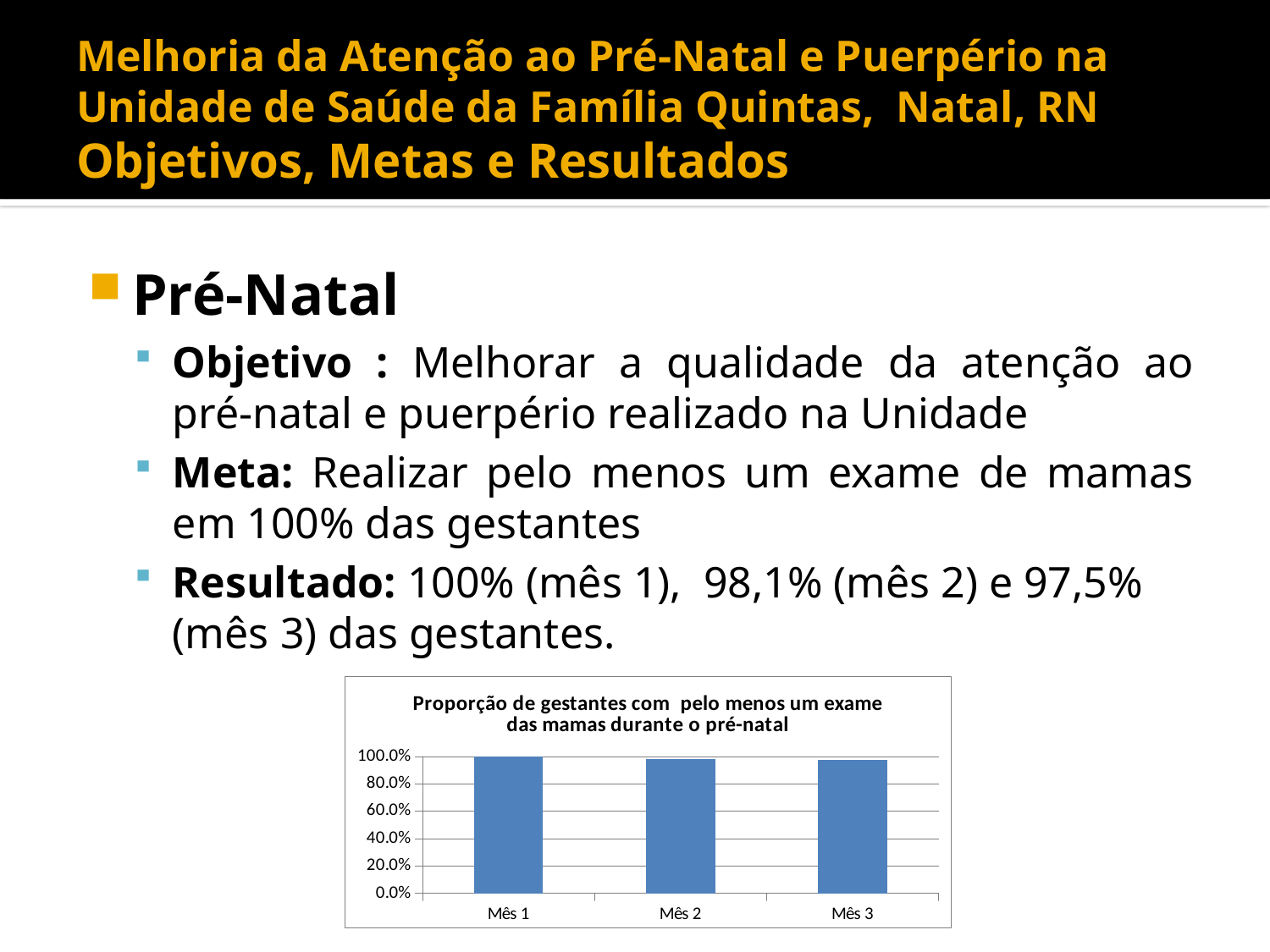
What is the highest value shown on the y axis of the chart? 100.0% What is the title of the chart? Proporção de gestantes com pelo menos um exame das mamas durante o pré-natal Is the value for Mês 3 greater or less than 60.0%? greater What kind of chart is shown on the slide? bar chart How many categories (months) are plotted in the chart? 3 What is the label of the first category on the x axis? Mês 1 Do the values rise or fall from Mês 1 to Mês 3? fall Is the value for Mês 1 greater or less than 40.0%? greater Is the value for Mês 2 greater or less than 80.0%? greater What is the value for Mês 1 in the chart? 100.0%